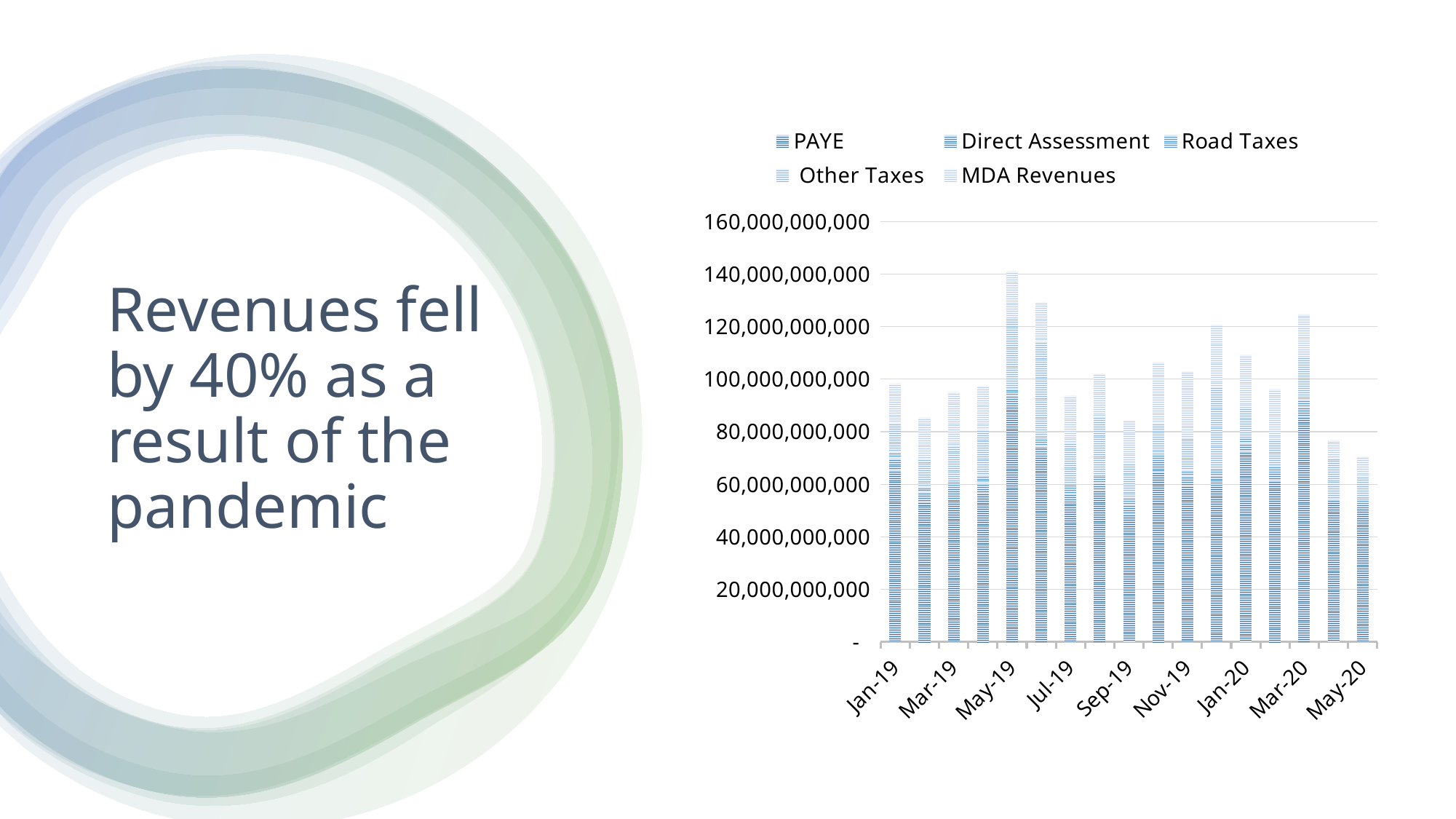
How many series does the chart legend list? 5 Which month has the shortest total bar in the chart? May-20 What kind of chart is shown on the slide? Stacked bar chart Do the total bars rise or fall from Mar-20 to May-20? fall Which month has the tallest total bar in the chart? May-19 Which month has a larger total bar, May-19 or May-20? May-19 Is the total value for Jan-20 greater or less than 100,000,000,000? greater Is the total value for May-19 greater or less than 120,000,000,000? greater Which series is listed first in the chart legend? PAYE How many monthly bars are plotted in the chart? 17 Is the total value for May-20 greater or less than 80,000,000,000? less